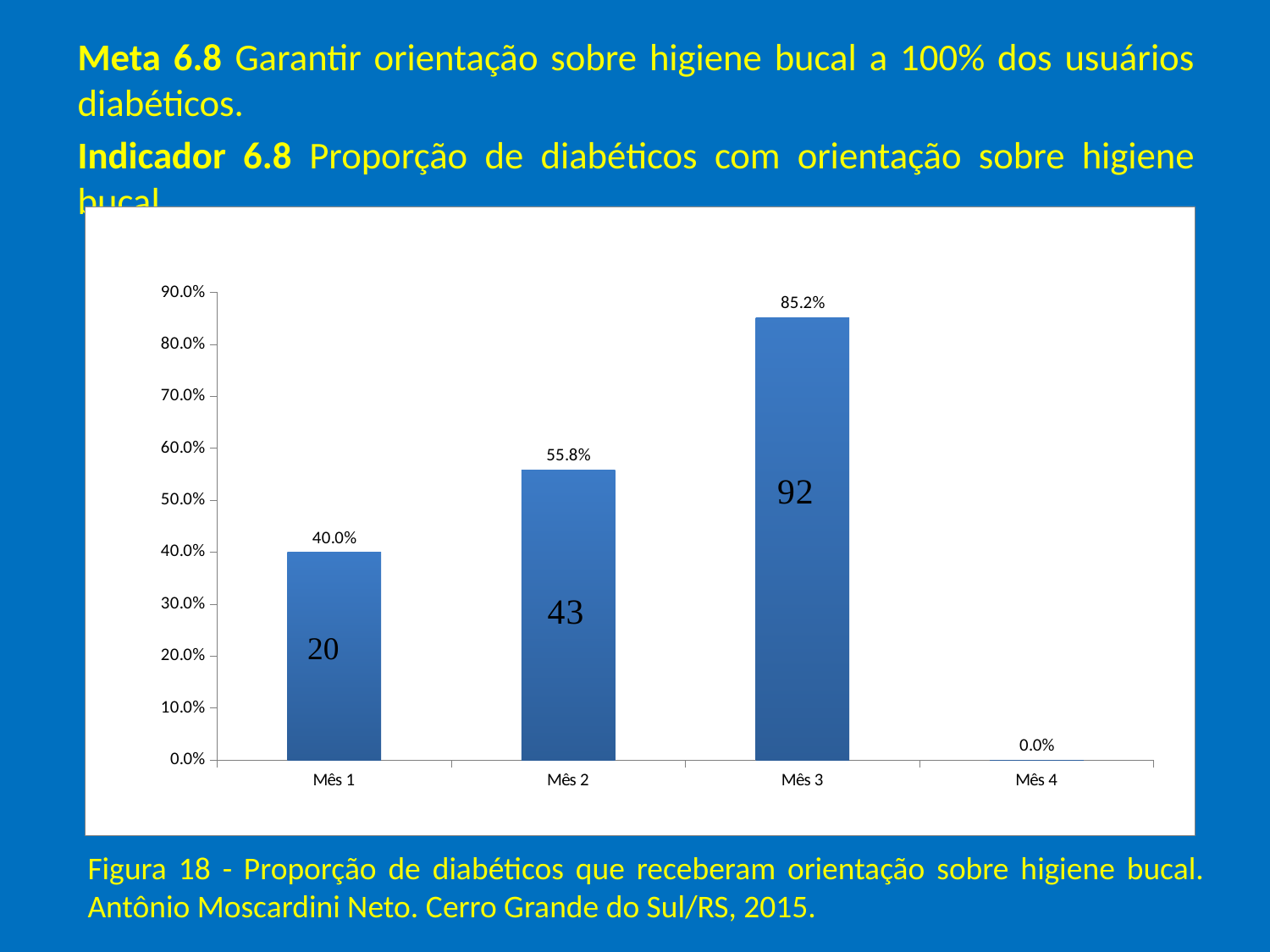
Do the values rise or fall from Mês 1 to Mês 3? rise What is the difference between the values for Mês 3 and Mês 2? 29.4% What is the value for Mês 1? 40.0% Which is larger, the value for Mês 1 or the value for Mês 2? Mês 2 What is the value for Mês 4? 0.0% What number is printed inside the bar for Mês 3? 92 What is the value for Mês 3? 85.2% What kind of chart is shown on the slide? bar chart How many months are shown on the x axis? 4 Which month has the highest value? Mês 3 Which month has the lowest value? Mês 4 What is the value for Mês 2? 55.8%